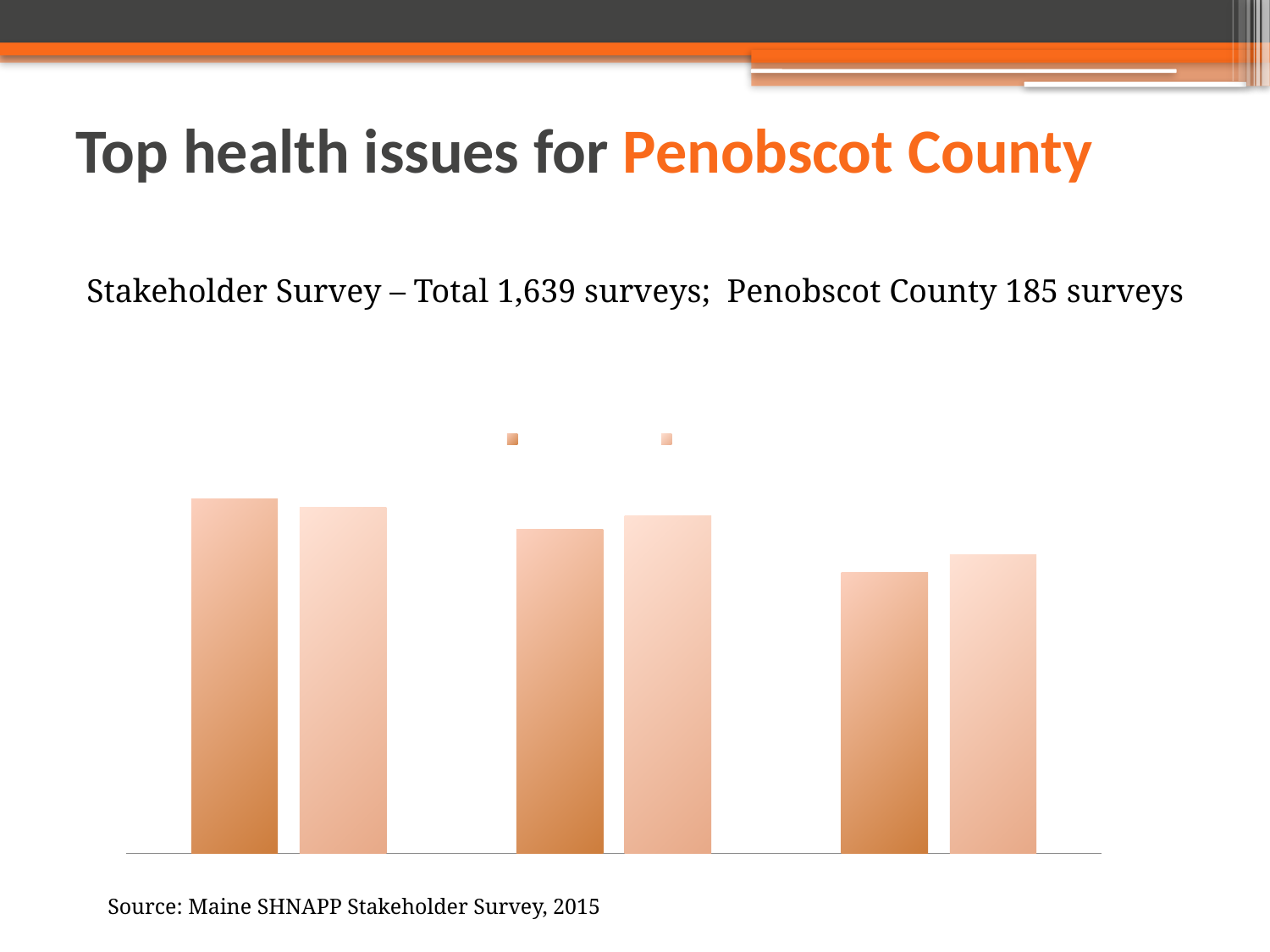
What kind of chart is shown on the slide? bar chart Which group of bars contains the shortest bar on the chart? the rightmost group Do the lighter orange bars rise or fall from left to right across the chart? fall How many series does the chart's legend list? 2 In the leftmost group of bars, is the darker orange bar or the lighter orange bar taller? the darker orange bar How many groups of bars (categories) does the chart show? 3 What source is cited below the chart? Maine SHNAPP Stakeholder Survey, 2015 In the rightmost group of bars, is the darker orange bar or the lighter orange bar taller? the lighter orange bar In the middle group of bars, is the darker orange bar or the lighter orange bar taller? the lighter orange bar Which group of bars contains the tallest bar on the chart? the leftmost group Do the darker orange bars rise or fall from left to right across the chart? fall Does the chart display numeric data labels on its bars? No